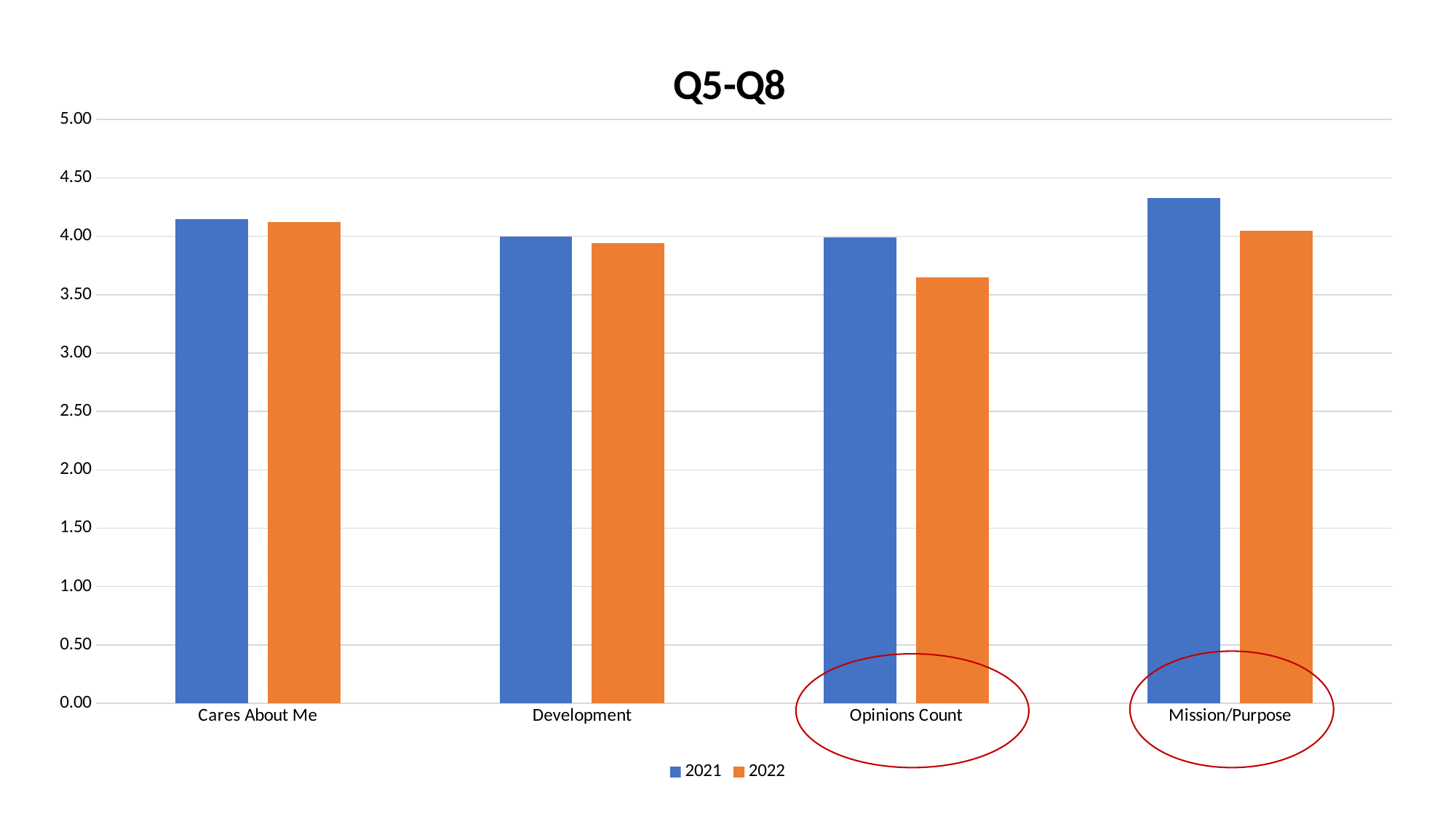
What kind of chart is shown on the slide? Bar chart How many categories are shown on the x axis? 4 Is the 2022 value for Opinions Count greater or less than 4.00? less What is the title of the chart? Q5-Q8 For Mission/Purpose, which is larger, the 2021 value or the 2022 value? 2021 How many series does the legend list? 2 Which category has the highest 2021 value? Mission/Purpose Is the 2021 value for Cares About Me greater or less than 4.00? greater Which category has the lowest 2022 value? Opinions Count Which two categories are circled in red on the chart? Opinions Count and Mission/Purpose Is the 2021 value for Mission/Purpose greater or less than 4.00? greater For Opinions Count, which is larger, the 2021 value or the 2022 value? 2021